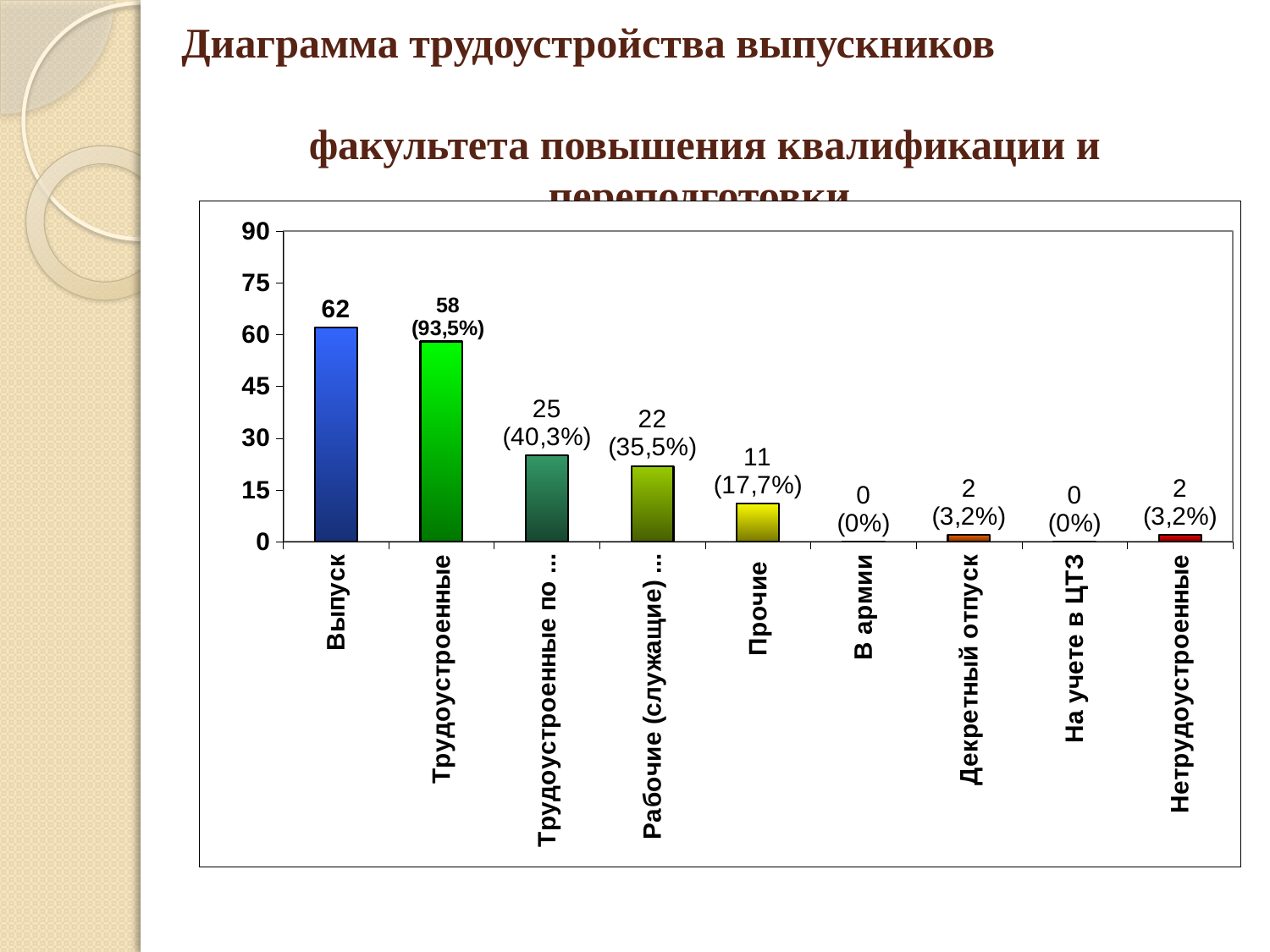
What is the value for Трудоустроенные? 58 Which is larger, the value for Прочие or the value for Нетрудоустроенные? Прочие What is the value for Выпуск? 62 Is the value for Трудоустроенные greater or less than 45? greater What is the difference between the values for Выпуск and Трудоустроенные? 4 What percentage is shown for Прочие? 17,7% What is the value for Декретный отпуск? 2 What is the value for В армии? 0 What kind of chart is this? bar chart Which category has the highest value? Выпуск What percentage is shown for Нетрудоустроенные? 3,2% How many categories are shown on the x axis? 9